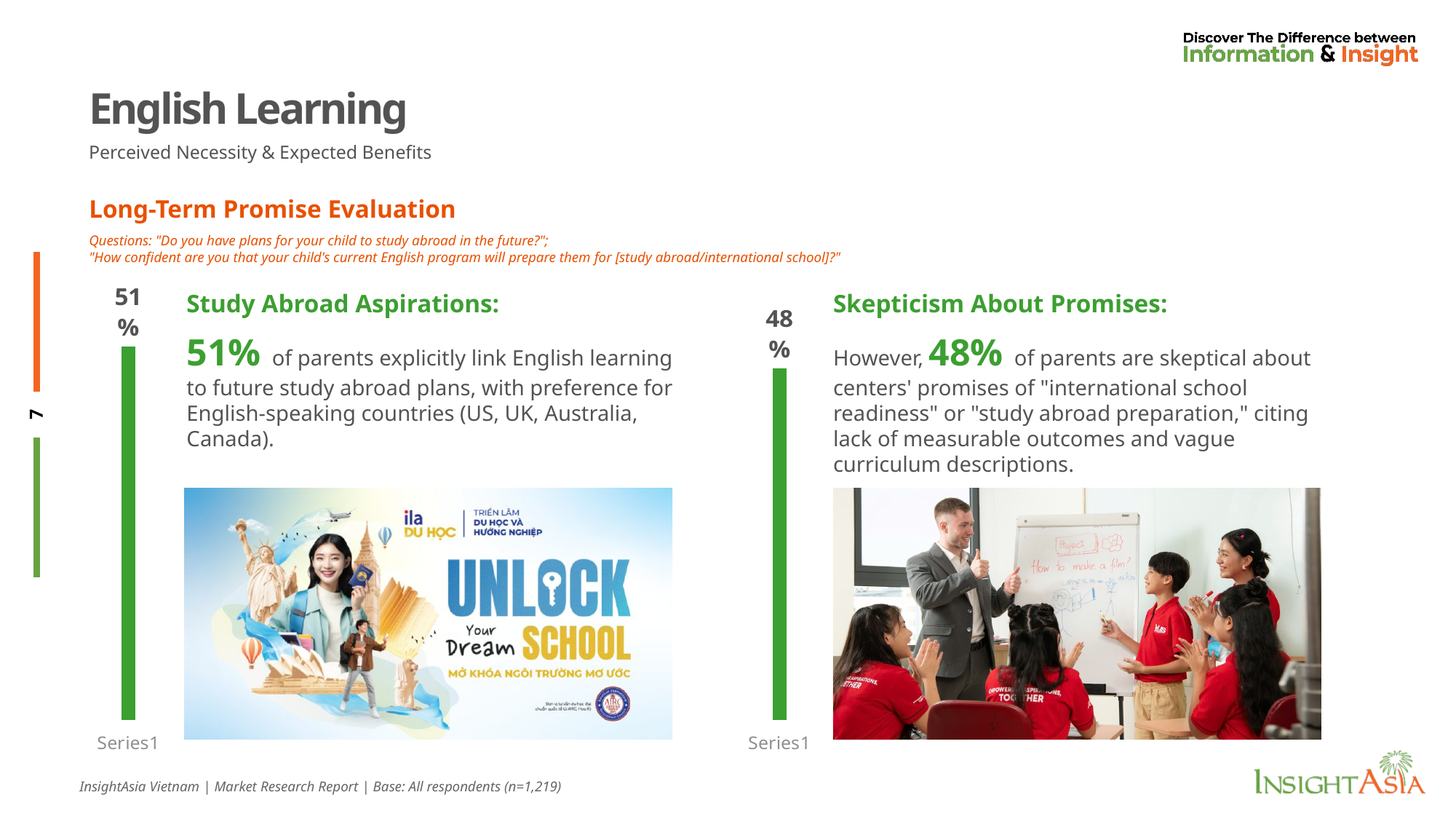
How many bars does the left chart next to 'Study Abroad Aspirations' have? 1 What kind of chart is the left chart next to 'Study Abroad Aspirations'? bar chart What is the difference between the bar value on the left chart (51%) and the bar value on the right chart (48%)? 3% Which is larger: the bar value on the left chart (Study Abroad Aspirations) or the bar value on the right chart (Skepticism About Promises)? left chart (51%) What kind of chart is the right chart next to 'Skepticism About Promises'? bar chart On the right chart next to 'Skepticism About Promises', what value is shown on the bar? 48% What is the category label shown under the bar on the left chart next to 'Study Abroad Aspirations'? Series1 What colour is the bar on the right chart next to 'Skepticism About Promises'? green On the left chart next to 'Study Abroad Aspirations', what value is shown on the bar? 51% How many bars does the right chart next to 'Skepticism About Promises' have? 1